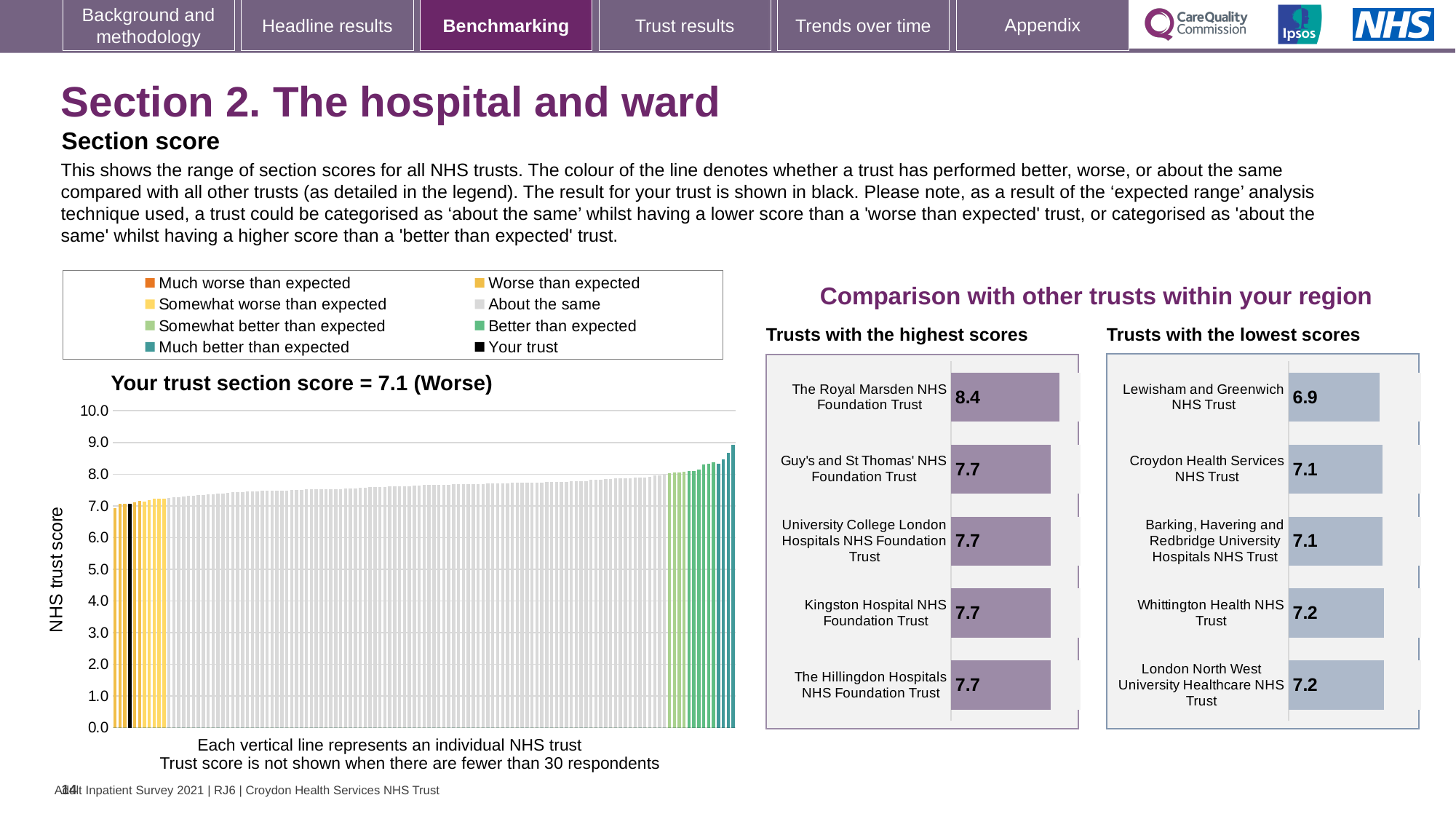
In the 'Trusts with the highest scores' chart, which trust has the highest score? The Royal Marsden NHS Foundation Trust In the 'Trusts with the lowest scores' chart, which trust has the lowest score? Lewisham and Greenwich NHS Trust In the 'Trusts with the lowest scores' chart, what is the score for Lewisham and Greenwich NHS Trust? 6.9 In the 'Trusts with the lowest scores' chart, what is the difference between the scores of Whittington Health NHS Trust and Lewisham and Greenwich NHS Trust? 0.3 In the 'Your trust section score' chart, do the trust scores rise or fall from left to right? Rise What kind of chart is the 'Your trust section score = 7.1 (Worse)' chart? Bar chart In the 'Trusts with the highest scores' chart, what is the difference between the scores of The Royal Marsden NHS Foundation Trust and Guy's and St Thomas' NHS Foundation Trust? 0.7 In the 'Trusts with the lowest scores' chart, which has the larger score: Whittington Health NHS Trust or Lewisham and Greenwich NHS Trust? Whittington Health NHS Trust How many trusts are shown in the 'Trusts with the highest scores' chart? 5 In the 'Trusts with the highest scores' chart, what is the score for Kingston Hospital NHS Foundation Trust? 7.7 In the 'Trusts with the highest scores' chart, what is the score for The Royal Marsden NHS Foundation Trust? 8.4 In the 'Your trust section score' chart, what is the section score for your trust? 7.1